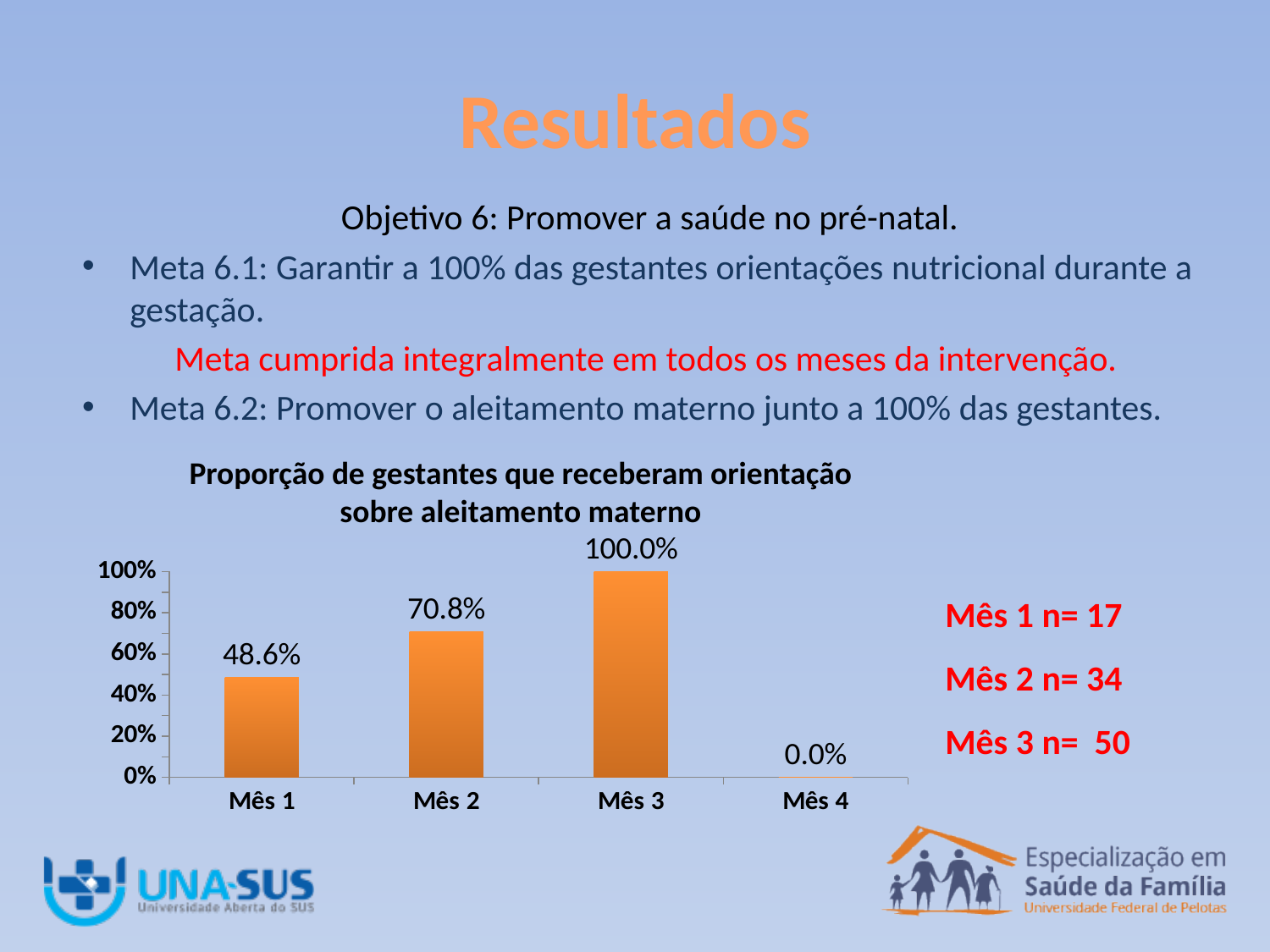
Which month has the lowest value? Mês 4 How many months are shown on the x axis? 4 Is the value for Mês 1 greater or less than 60%? less Which month has the highest value? Mês 3 What is the value for Mês 3? 100.0% What is the difference between the values for Mês 2 and Mês 1? 22.2% What is the value for Mês 4? 0.0% What is the value for Mês 1? 48.6% What is the title of the chart? Proporção de gestantes que receberam orientação sobre aleitamento materno What kind of chart is shown on the slide? bar chart What is the value for Mês 2? 70.8% Which is larger, the value for Mês 1 or the value for Mês 2? Mês 2